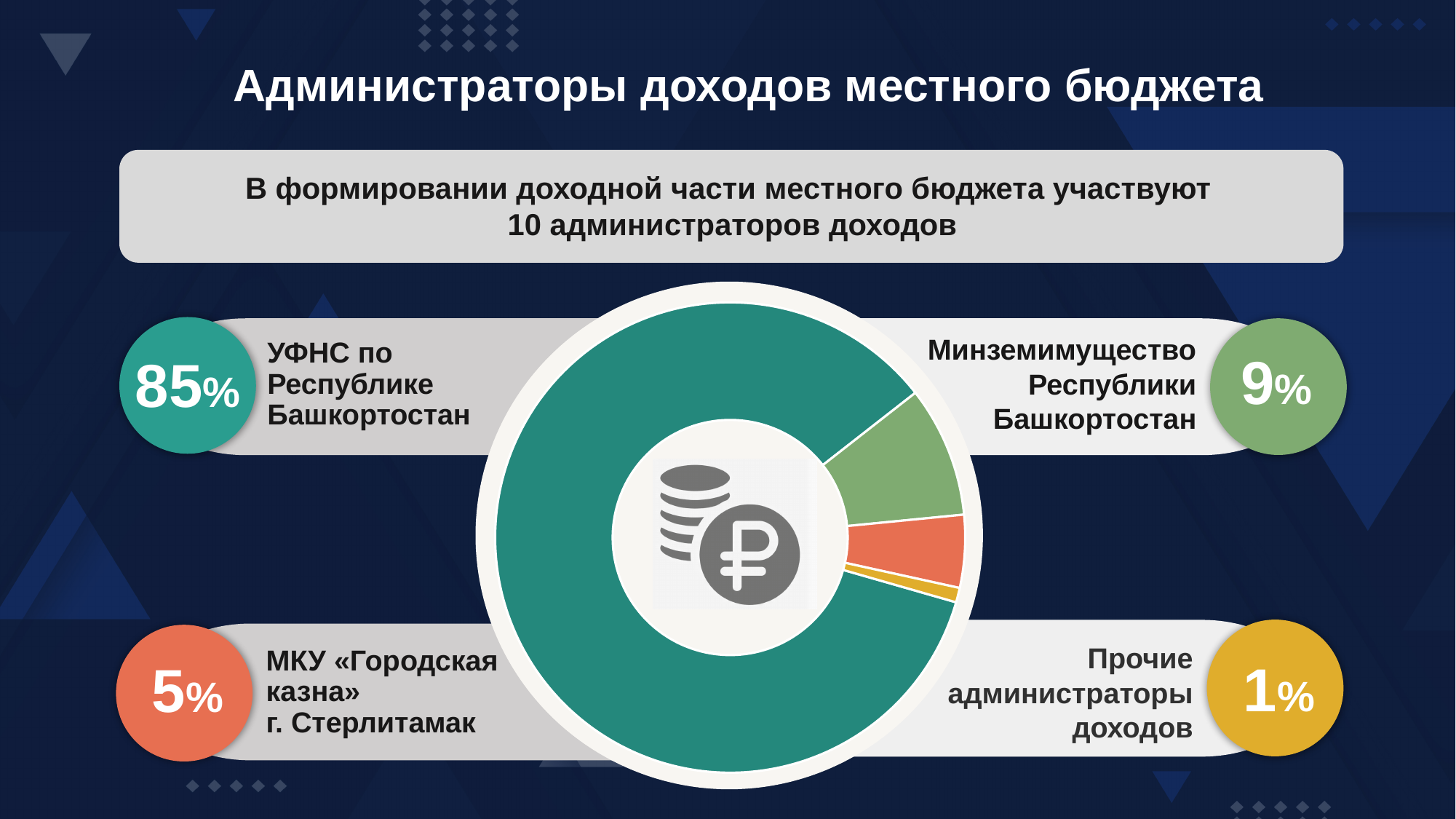
How many slices does the chart have? 4 What colour is the slice for МКУ «Городская казна» г. Стерлитамак? Orange (red-orange) What share is attributed to МКУ «Городская казна» г. Стерлитамак? 5% What kind of chart is shown on the slide? Pie chart (donut) Which administrator has the smallest share of the chart? Прочие администраторы доходов What share is attributed to Прочие администраторы доходов? 1% What is the difference between the shares of УФНС по Республике Башкортостан and Минземимущество Республики Башкортостан? 76% What share of local budget revenue is administered by УФНС по Республике Башкортостан? 85% Which administrator has the largest share of the chart? УФНС по Республике Башкортостан What share is attributed to Минземимущество Республики Башкортостан? 9% What is the title of the slide containing the chart? Администраторы доходов местного бюджета Which is larger: the share of Минземимущество Республики Башкортостан or the share of МКУ «Городская казна» г. Стерлитамак? Минземимущество Республики Башкортостан